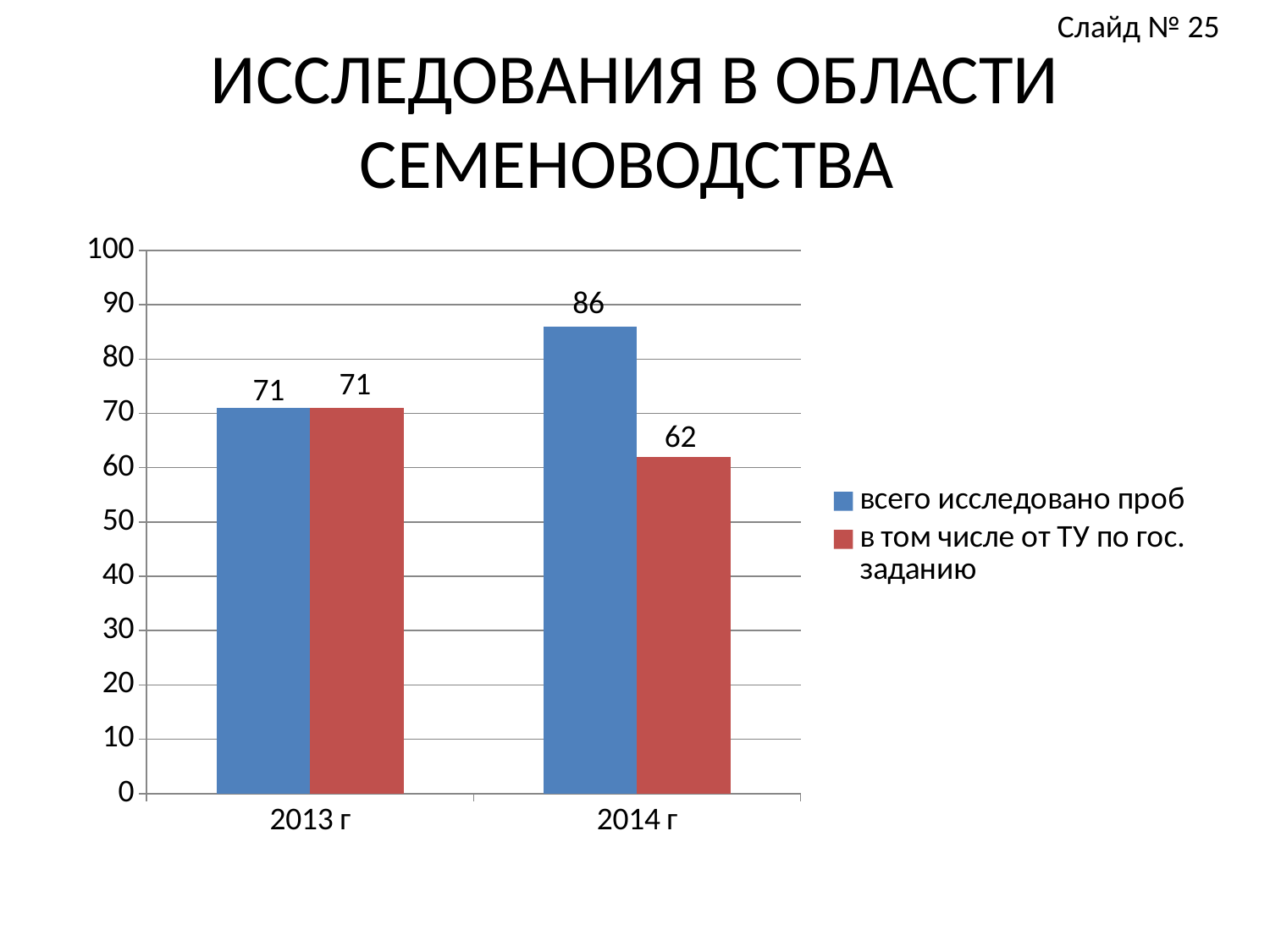
How many categories are shown on the x axis? 2 What kind of chart is shown on the slide? bar chart How many series does the legend list? 2 Which is larger in 2014 г: 'всего исследовано проб' or 'в том числе от ТУ по гос. заданию'? всего исследовано проб What is the value of 'в том числе от ТУ по гос. заданию' for 2014 г? 62 What is the value of 'в том числе от ТУ по гос. заданию' for 2013 г? 71 What is the difference between 'всего исследовано проб' and 'в том числе от ТУ по гос. заданию' in 2014 г? 24 In which year is 'всего исследовано проб' highest? 2014 г By how much did 'всего исследовано проб' increase from 2013 г to 2014 г? 15 What is the value of 'всего исследовано проб' for 2013 г? 71 What is the value of 'всего исследовано проб' for 2014 г? 86 In which year is 'в том числе от ТУ по гос. заданию' lowest? 2014 г